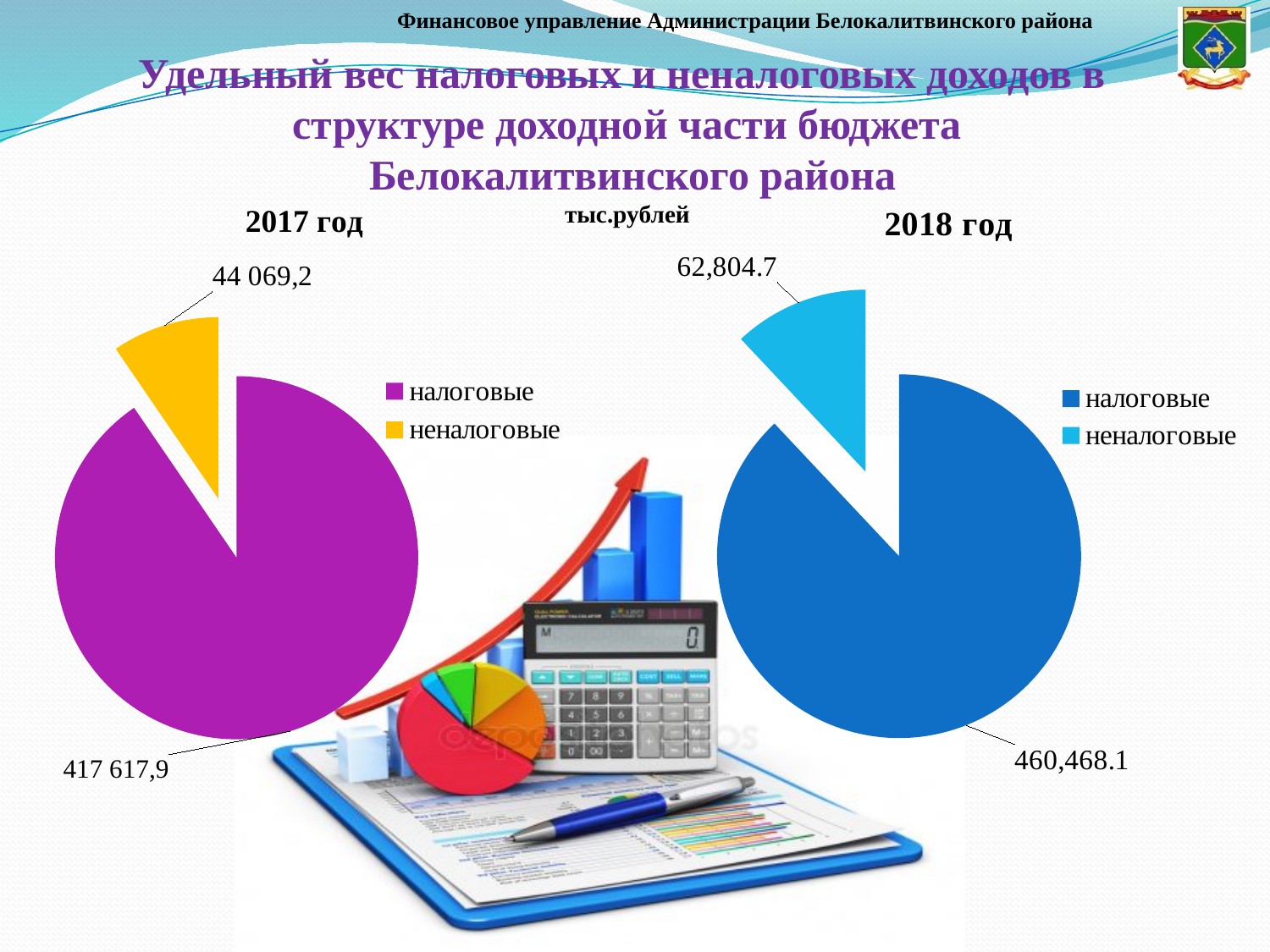
On the 2018 год pie chart, what is the value for налоговые? 460,468.1 On the 2017 год pie chart, which category has the smallest slice? неналоговые On the 2018 год pie chart, which category has the largest slice? налоговые What type of chart is used for 2017 год? pie chart On the 2017 год pie chart, what is the value for неналоговые? 44 069,2 On the 2018 год pie chart, what is the value for неналоговые? 62,804.7 On the 2017 год pie chart, what is the value for налоговые? 417 617,9 How many slices does the 2018 год pie chart have? 2 Which is larger: неналоговые in the 2017 год chart or неналоговые in the 2018 год chart? 2018 год On the 2018 год pie chart, what is the difference between налоговые and неналоговые? 397,663.4 On the 2017 год pie chart, what is the difference between налоговые and неналоговые? 373 548,7 What unit is stated between the two charts? тыс.рублей